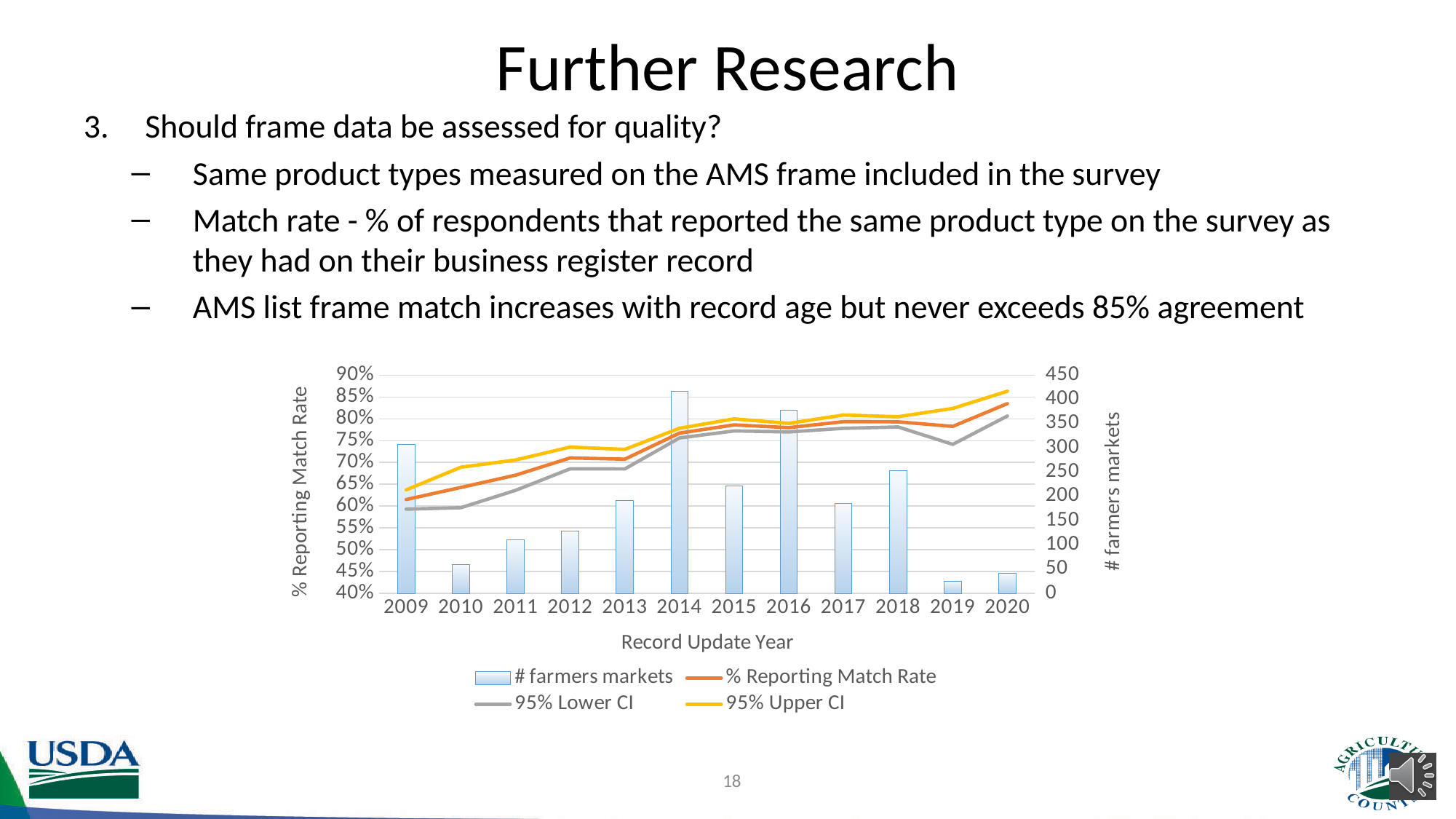
Which record update year has the lowest number of farmers markets? 2019 Is the % Reporting Match Rate for 2009 greater or less than 65%? less Which year has more farmers markets, 2009 or 2018? 2009 Which record update year has the highest number of farmers markets? 2014 What is the title of the x axis of the chart? Record Update Year Is the number of farmers markets for 2014 greater or less than 350? greater Is the number of farmers markets for 2010 greater or less than 100? less What kind of chart is shown on the slide? A combination bar and line chart How many record update years are shown on the x axis of the chart? 12 How many series does the chart legend list? 4 Does the % Reporting Match Rate line generally rise or fall from 2009 to 2020? rise